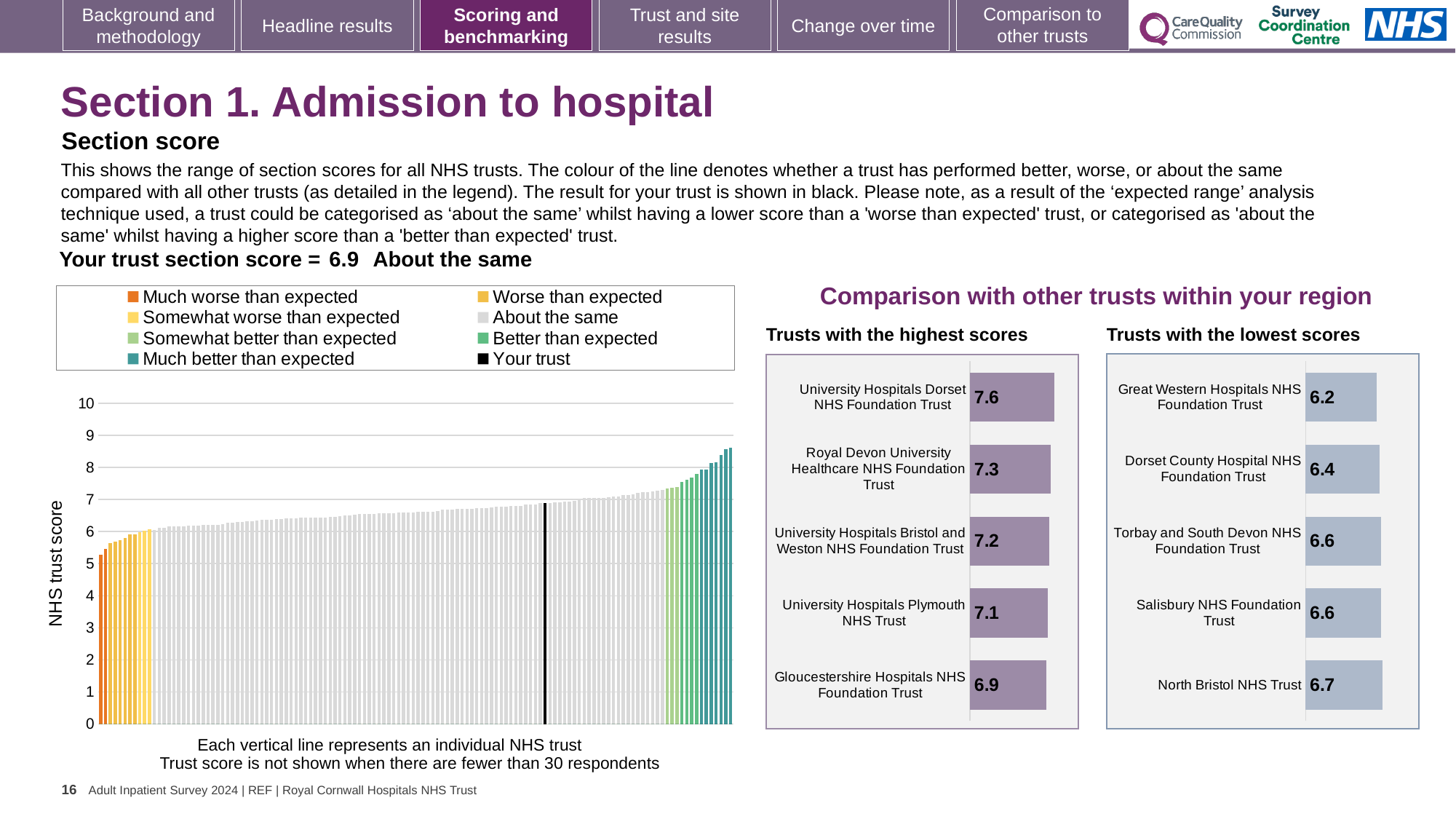
In the large chart on the left, do the trust scores rise or fall from left to right? Rise What type of chart is the large chart on the left showing NHS trust scores? Bar chart In the 'Trusts with the lowest scores' chart, which trust has the lowest score? Great Western Hospitals NHS Foundation Trust In the 'Trusts with the highest scores' chart, what is the difference between the scores of University Hospitals Dorset NHS Foundation Trust and University Hospitals Plymouth NHS Trust? 0.5 In the 'Trusts with the highest scores' chart, what is the score for Gloucestershire Hospitals NHS Foundation Trust? 6.9 How many categories does the legend of the large chart on the left list? 8 In the 'Trusts with the lowest scores' chart, what is the score for North Bristol NHS Trust? 6.7 In the 'Trusts with the highest scores' chart, which trust has the highest score? University Hospitals Dorset NHS Foundation Trust In the large chart on the left, is the value of the leftmost (orange) bar greater or less than 6? less In the 'Trusts with the highest scores' chart, what is the score for University Hospitals Dorset NHS Foundation Trust? 7.6 How many trusts are shown in the 'Trusts with the lowest scores' chart? 5 In the 'Trusts with the lowest scores' chart, which has the higher score: Dorset County Hospital NHS Foundation Trust or Torbay and South Devon NHS Foundation Trust? Torbay and South Devon NHS Foundation Trust